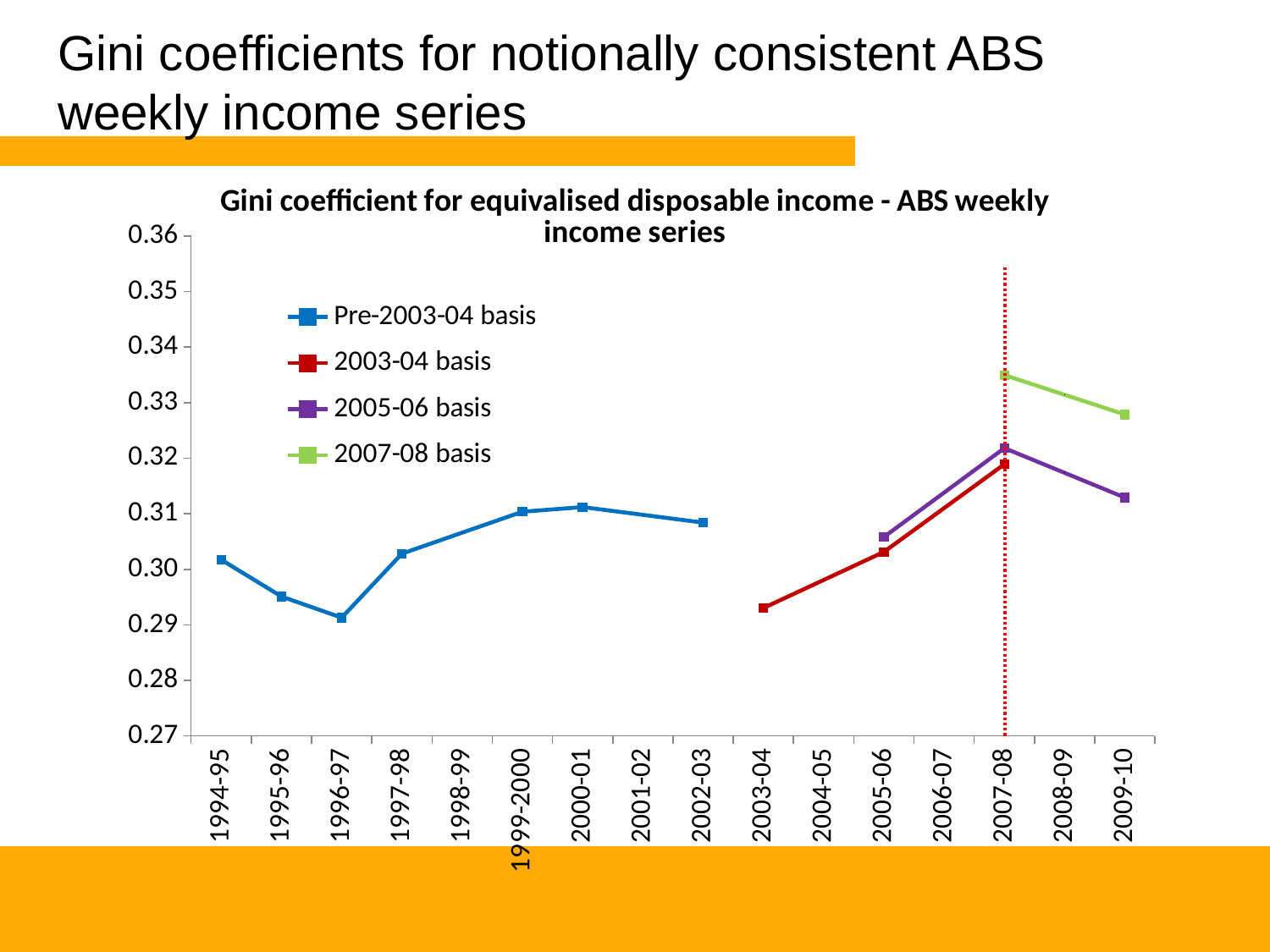
How many series does the legend list? 4 What are the four series named in the legend? Pre-2003-04 basis, 2003-04 basis, 2005-06 basis, 2007-08 basis In 2007-08, which series has the larger value: the 2007-08 basis or the 2005-06 basis? 2007-08 basis In which year does the Pre-2003-04 basis series reach its lowest value? 1996-97 Is the value for the 2003-04 basis series in 2003-04 greater or less than 0.30? less Does the 2007-08 basis series rise or fall from 2007-08 to 2009-10? fall Is the value for the 2005-06 basis series in 2009-10 greater or less than 0.32? less Is the value for the 2007-08 basis series in 2007-08 greater or less than 0.33? greater What kind of chart is shown on the slide? line chart How many year categories are shown on the x axis? 16